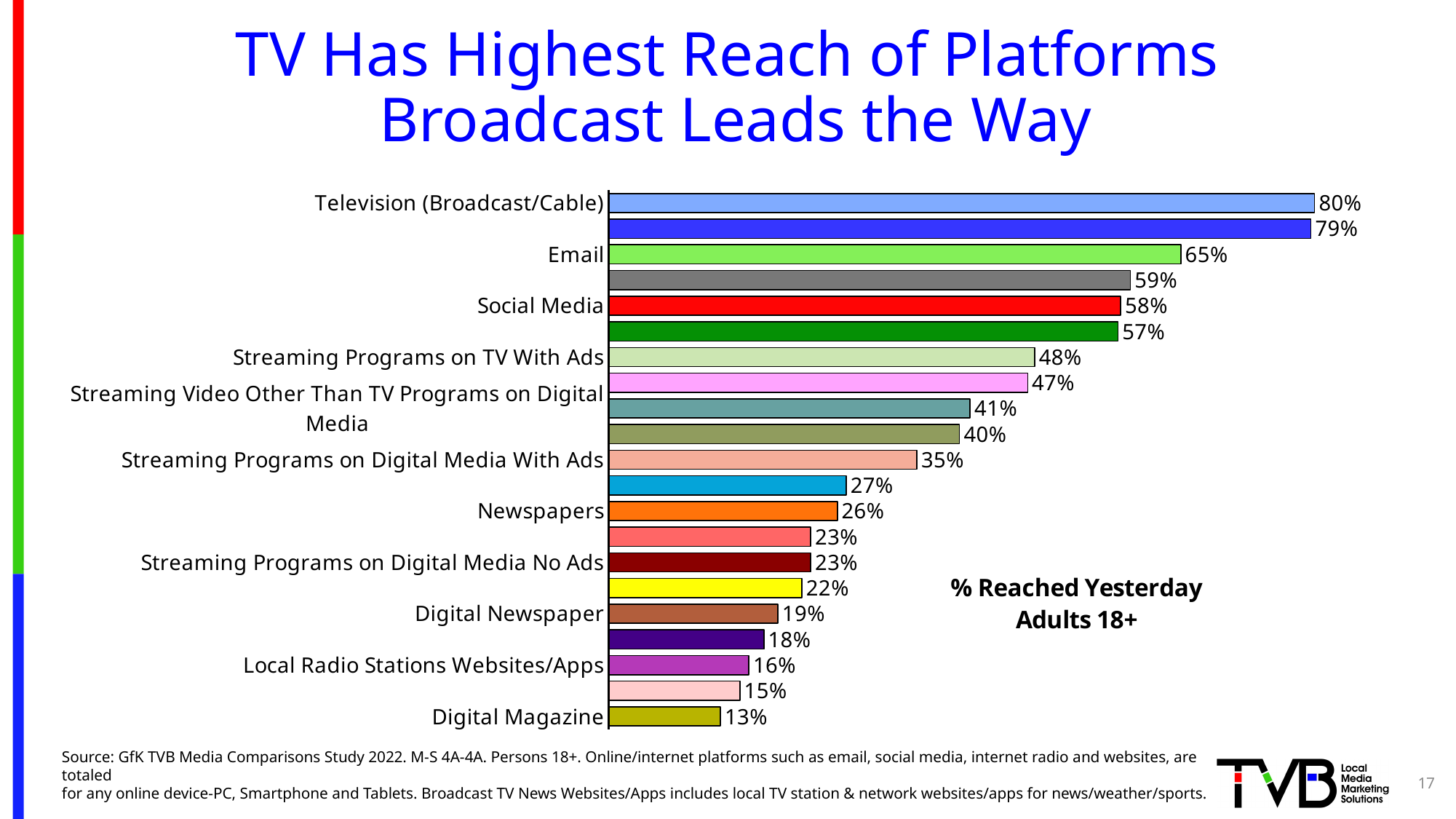
What is the value for Newspapers? 26% What is the value for Streaming Programs on TV With Ads? 48% Which labeled category has the highest value? Television (Broadcast/Cable) What is the value for Digital Magazine? 13% What kind of chart is shown on the slide? bar chart What is the value for Social Media? 58% What is the difference between the values for Television (Broadcast/Cable) and Email? 15 percentage points What is the value for Email? 65% What is the value for Television (Broadcast/Cable)? 80% How many bars are plotted in the chart? 21 Which is larger, the value for Email or the value for Social Media? Email Which labeled category has the lowest value? Digital Magazine